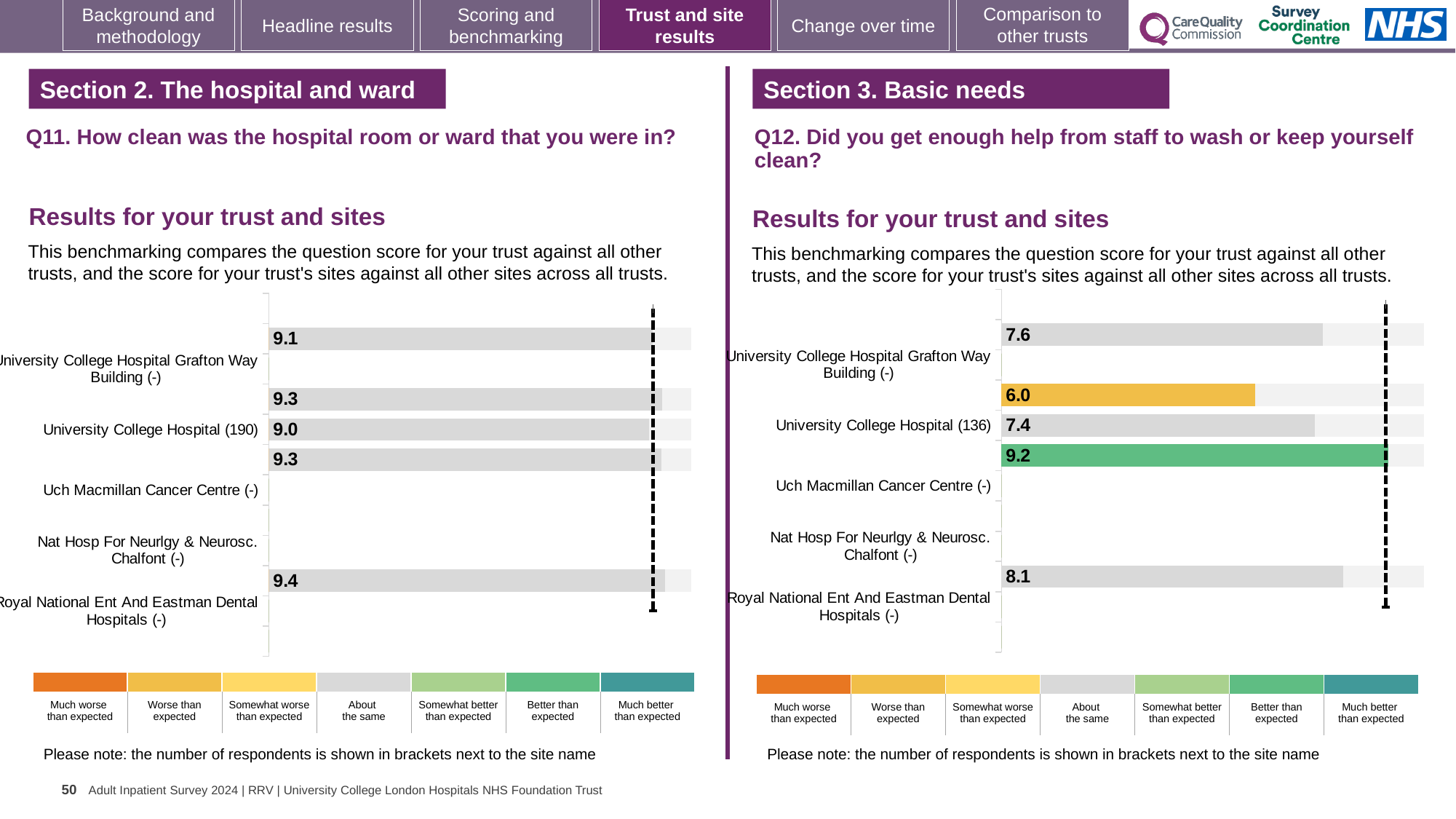
In the Q12 chart on the right, what is the score for University College Hospital (136)? 7.4 In the Q12 chart on the right, what is the lowest value shown on any bar? 6.0 In the Q12 chart on the right, what is the difference between the highest bar value (9.2) and the lowest bar value (6.0)? 3.2 In the Q11 chart on the left, what is the highest value shown on any bar? 9.4 In the Q12 chart on the right, which bar value is coloured green? 9.2 Which is larger: the score for University College Hospital (190) in the Q11 chart or the score for University College Hospital (136) in the Q12 chart? University College Hospital (190) in the Q11 chart In the Q11 chart on the left, what is the difference between the highest bar value (9.4) and the lowest bar value (9.0)? 0.4 How many bars are plotted in the Q11 chart on the left? 5 What type of chart is used for Q11 on the left side of the slide? bar chart In the Q11 chart on the left, what is the score for University College Hospital (190)? 9.0 In the Q12 chart on the right, what is the highest value shown on any bar? 9.2 In the Q11 chart on the left, what is the lowest value shown on any bar? 9.0